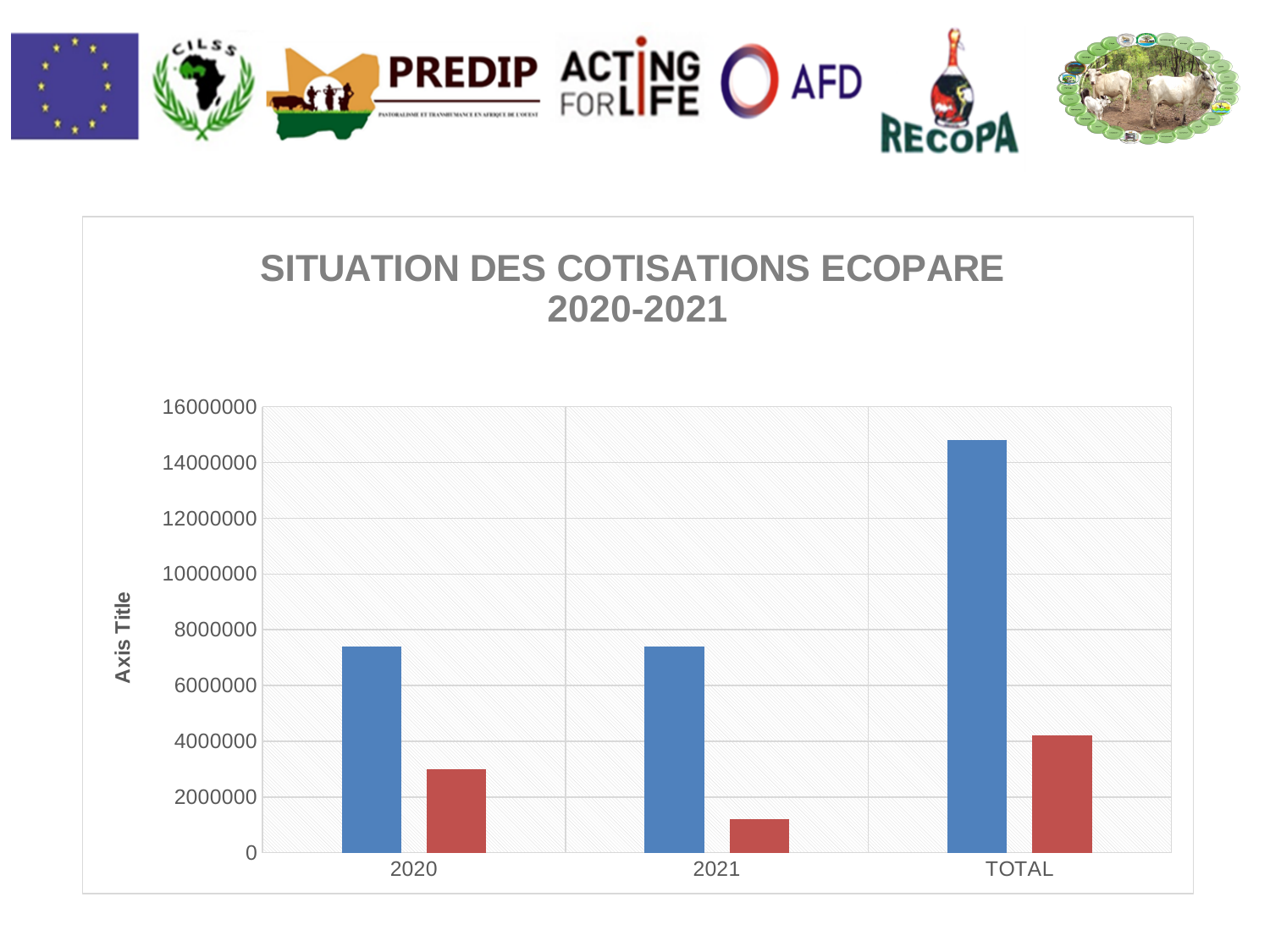
Among the blue bars, which category has the highest value? TOTAL Among the red bars, which category has the lowest value? 2021 Is the value of the blue bar for 2020 greater or less than 6000000? greater Is the value of the blue bar for TOTAL greater or less than 14000000? greater What kind of chart is shown on the slide? bar chart For 2020, which bar is larger, the blue bar or the red bar? blue Is the value of the red bar for 2020 greater or less than 4000000? less How many categories are shown on the x axis of the chart? 3 What is the title of the chart? SITUATION DES COTISATIONS ECOPARE 2020-2021 Among the red bars, which category has the highest value? TOTAL What is the label of the vertical axis? Axis Title